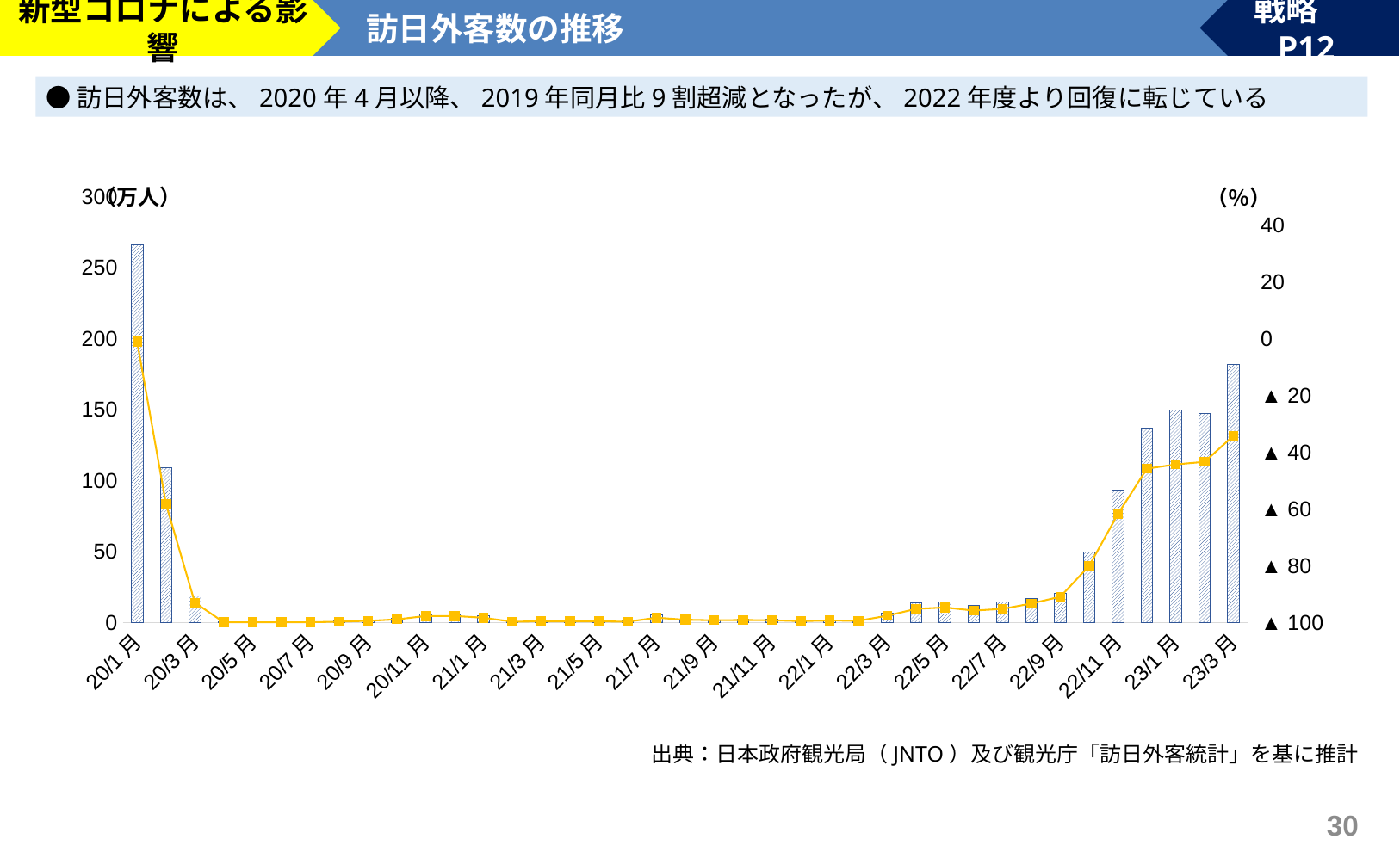
Which month has the tallest bar in the chart? 20/1月 Is the bar value for 22/11月 greater or less than 100? less Is the bar value for 20/1月 greater or less than 250? greater What unit is shown on the left vertical axis of the chart? 万人 Do the bars rise or fall from 20/1月 to 20/5月? fall What kind of chart is shown on the slide? A combined bar and line chart Do the bars rise or fall from 22/9月 to 23/3月? rise What is the title of the chart on the slide? 訪日外客数の推移 Is the bar value for 20/3月 greater or less than 50? less Which bar is taller, 22/9月 or 22/11月? 22/11月 Which bar is taller, 20/1月 or 23/3月? 20/1月